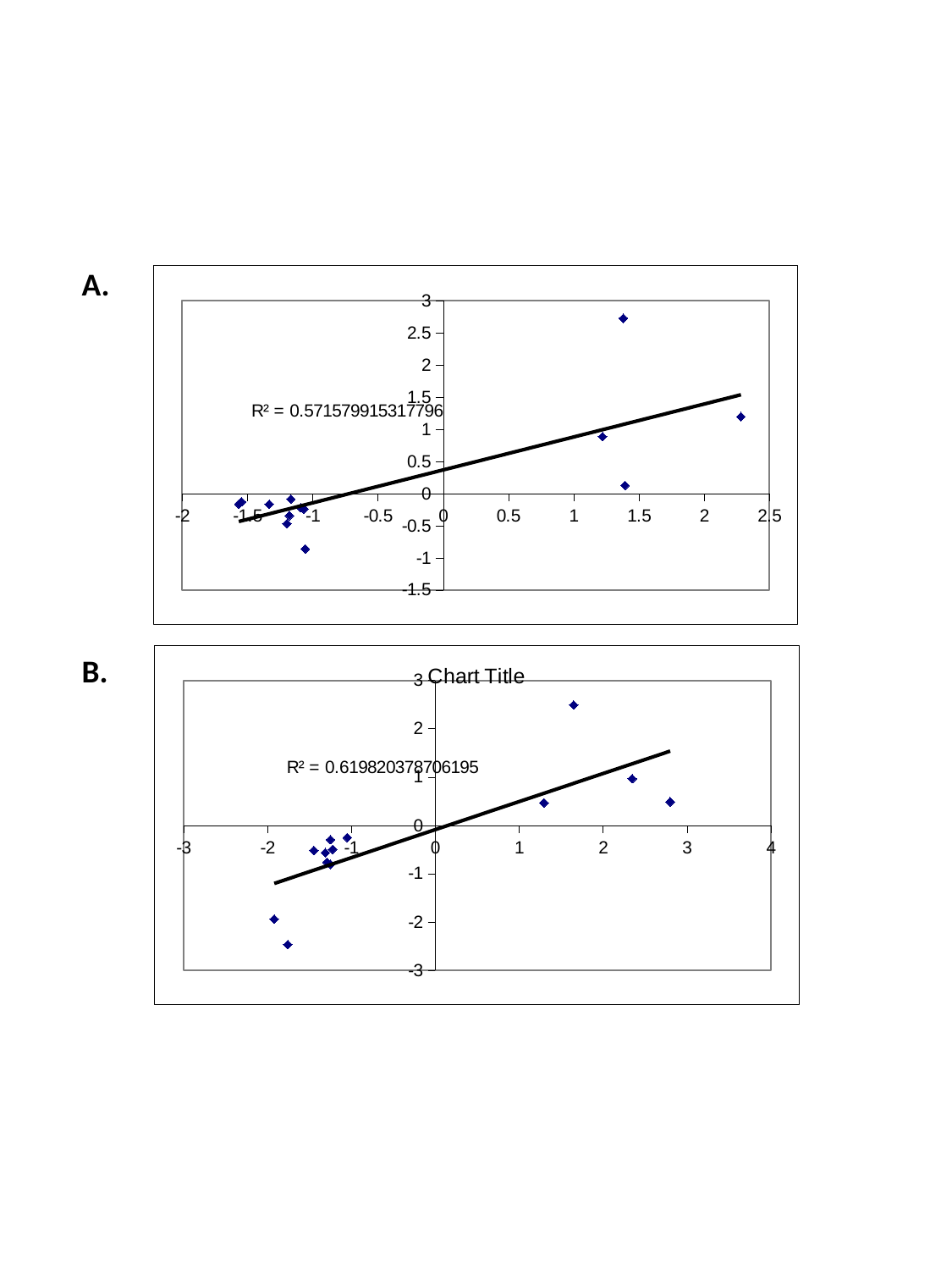
What is the title of chart B? Chart Title In chart B, is the y value of the lowest point greater or less than -2? less In chart B, is the y value of the highest point greater or less than 2? greater What R² value is shown on chart A? R² = 0.571579915317796 In chart B, does the trendline rise or fall as x increases? rises What is the largest tick value on the x axis of chart B? 4 What kind of chart is chart A? scatter chart In chart A, is the y value of the rightmost point greater or less than 1.5? less What R² value is shown on chart B? R² = 0.619820378706195 In chart A, does the trendline rise or fall as x increases? rises Which chart has the larger R² value, chart A or chart B? chart B